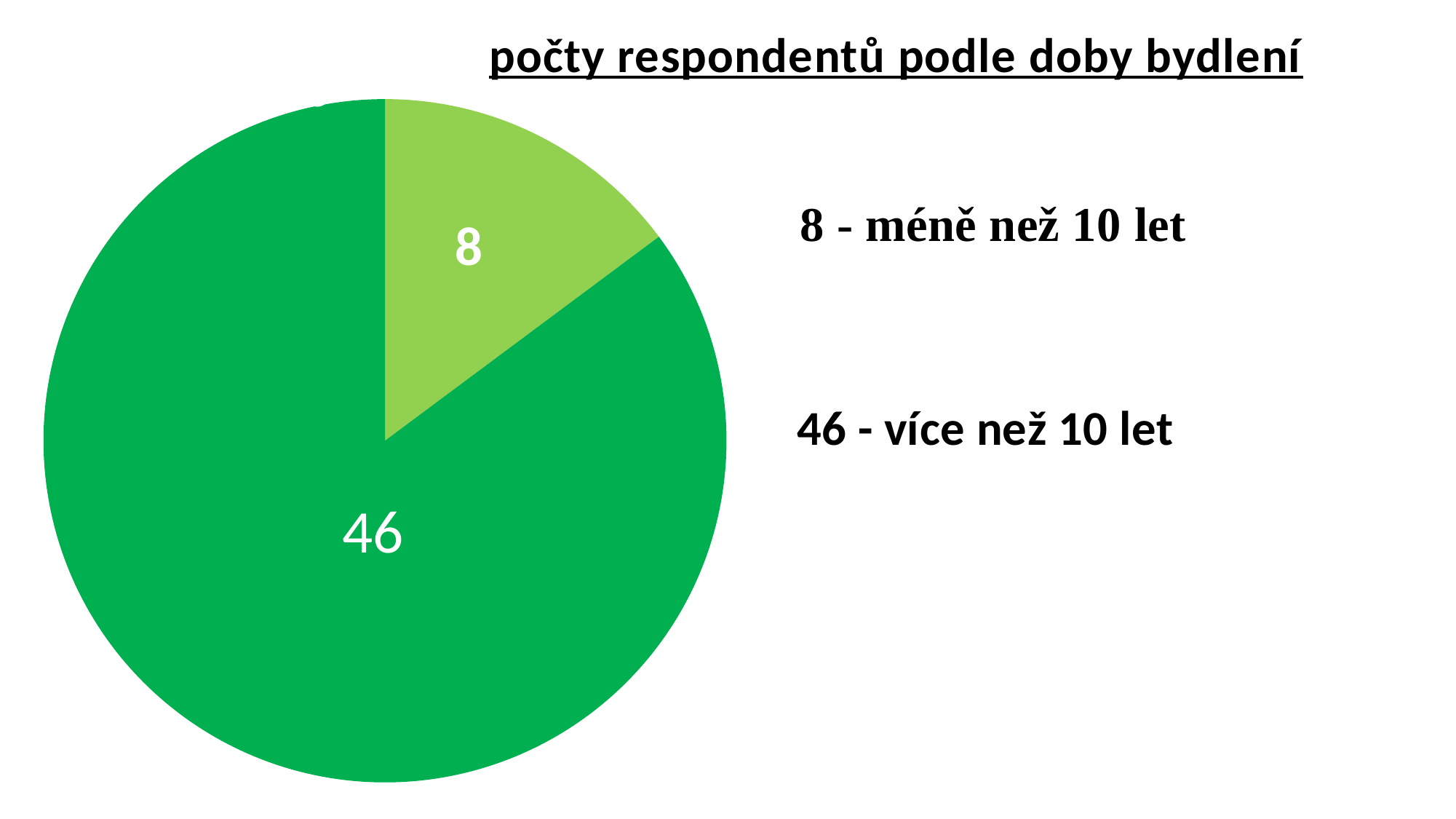
How many slices does the pie chart have? 2 How many respondents lived there more than 10 years (více než 10 let)? 46 Which is larger: the number of respondents with less than 10 years or with more than 10 years of residence? více než 10 let Which category has the fewest respondents? méně než 10 let What is the difference between the number of respondents living more than 10 years and those living less than 10 years? 38 How many respondents lived there less than 10 years (méně než 10 let)? 8 What is the title of the chart? počty respondentů podle doby bydlení Which colour is the slice for 'více než 10 let'? dark green What kind of chart is shown on the slide? pie chart Which category has the most respondents? více než 10 let What is the total number of respondents shown in the pie chart? 54